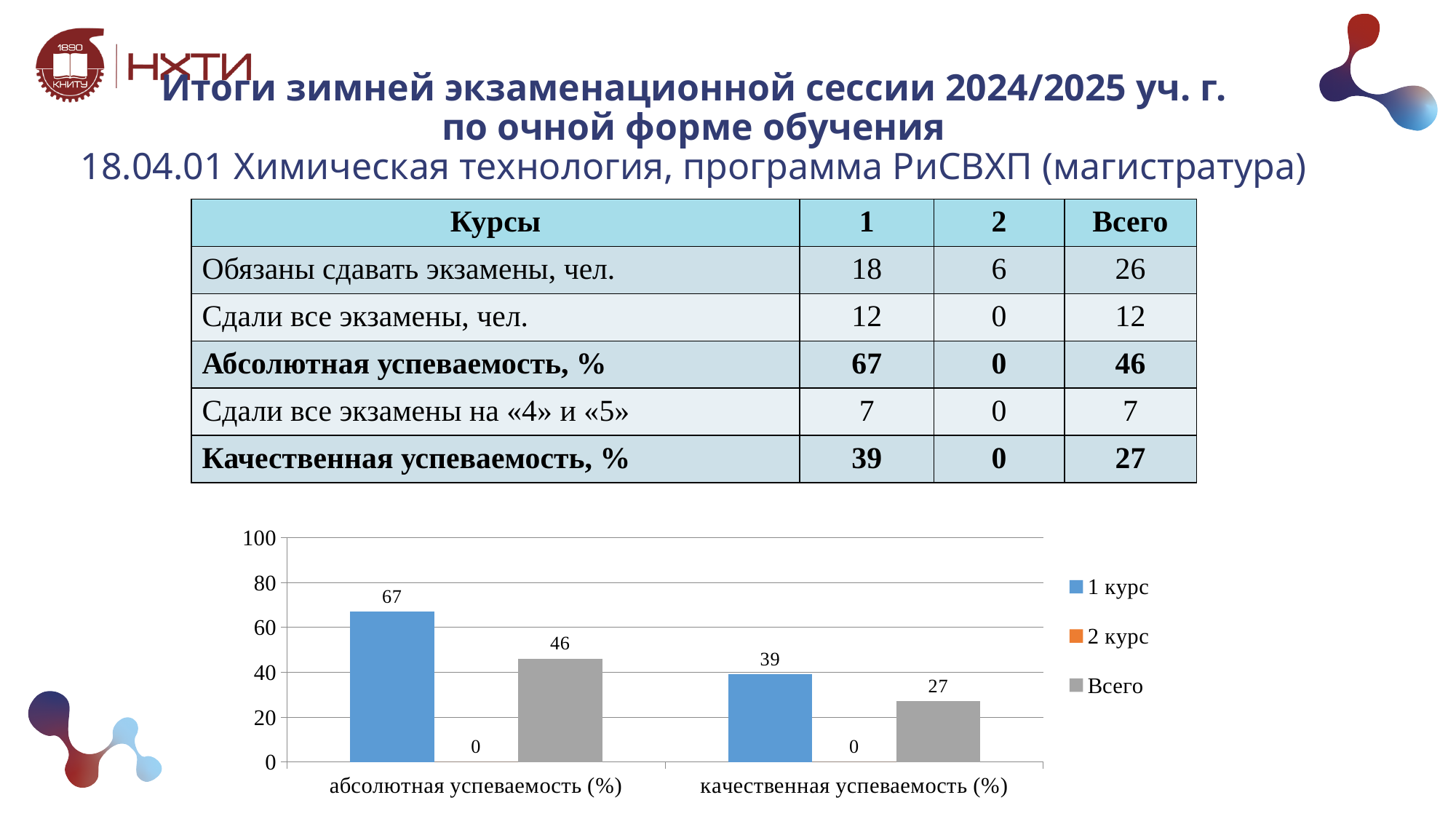
What is the value for "Всего" in the "качественная успеваемость (%)" category? 27 Which is larger: the "1 курс" value for "абсолютная успеваемость (%)" or the "1 курс" value for "качественная успеваемость (%)"? абсолютная успеваемость (%) What is the value for "1 курс" in the "абсолютная успеваемость (%)" category? 67 Which series has the highest value in the "качественная успеваемость (%)" category? 1 курс What is the difference between the "1 курс" and "Всего" values in the "абсолютная успеваемость (%)" category? 21 Is the "Всего" value for "качественная успеваемость (%)" greater or less than 40? less What is the value for "Всего" in the "абсолютная успеваемость (%)" category? 46 How many series does the chart legend list? 3 What kind of chart is shown on the slide? bar chart Which series has the lowest value in the "абсолютная успеваемость (%)" category? 2 курс What is the value for "2 курс" in the "абсолютная успеваемость (%)" category? 0 How many categories are shown on the x axis of the chart? 2